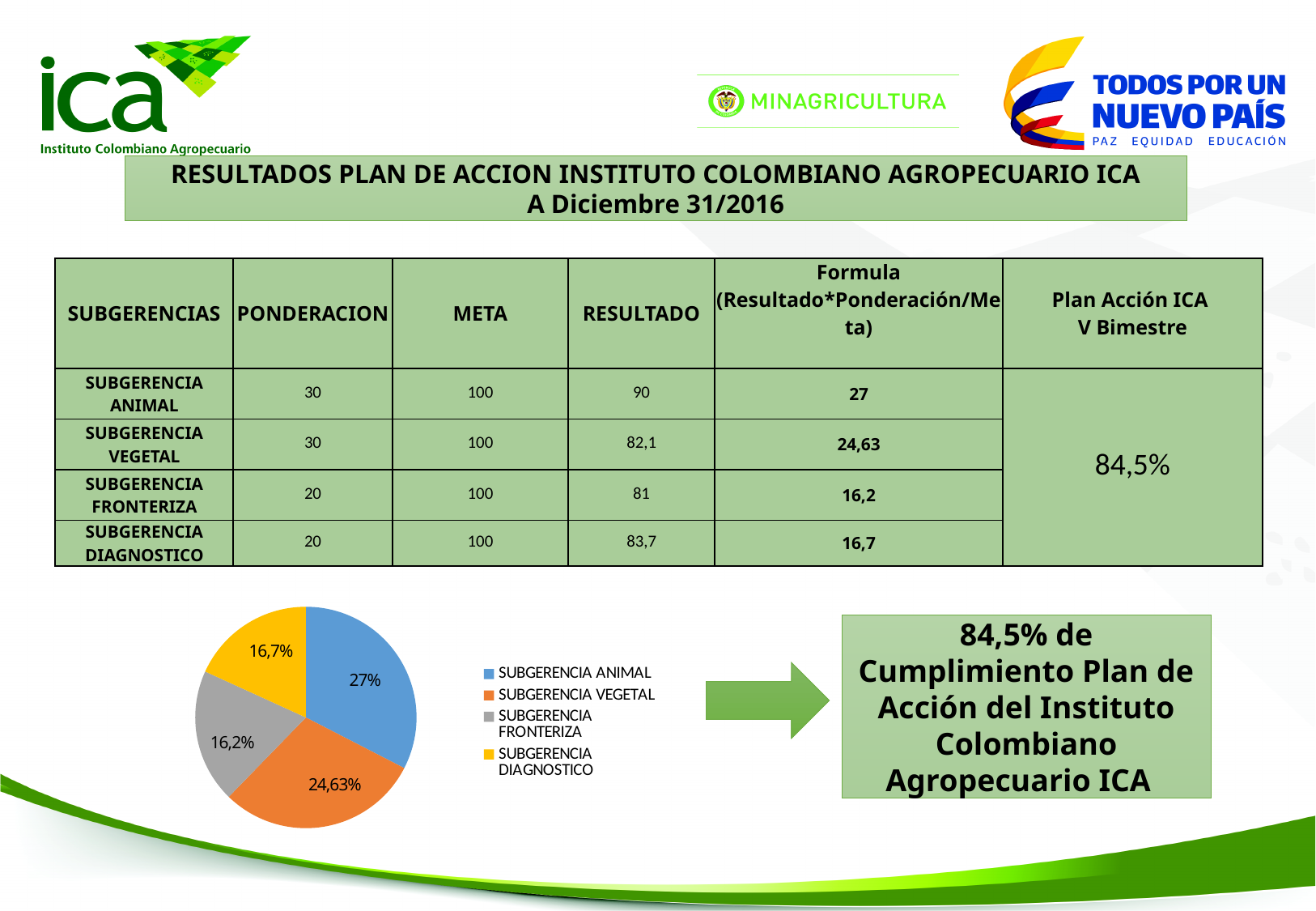
What value is shown for SUBGERENCIA DIAGNOSTICO in the pie chart? 16,7% What is the difference between the values for SUBGERENCIA ANIMAL and SUBGERENCIA VEGETAL in the pie chart? 2,37% Which category has the largest slice in the pie chart? SUBGERENCIA ANIMAL What value is shown for SUBGERENCIA FRONTERIZA in the pie chart? 16,2% How many entries does the pie chart legend list? 4 How many slices does the pie chart have? 4 What kind of chart is shown on the slide? Pie chart What colour is the SUBGERENCIA VEGETAL slice in the pie chart? Orange What value is shown for SUBGERENCIA ANIMAL in the pie chart? 27% What value is shown for SUBGERENCIA VEGETAL in the pie chart? 24,63%